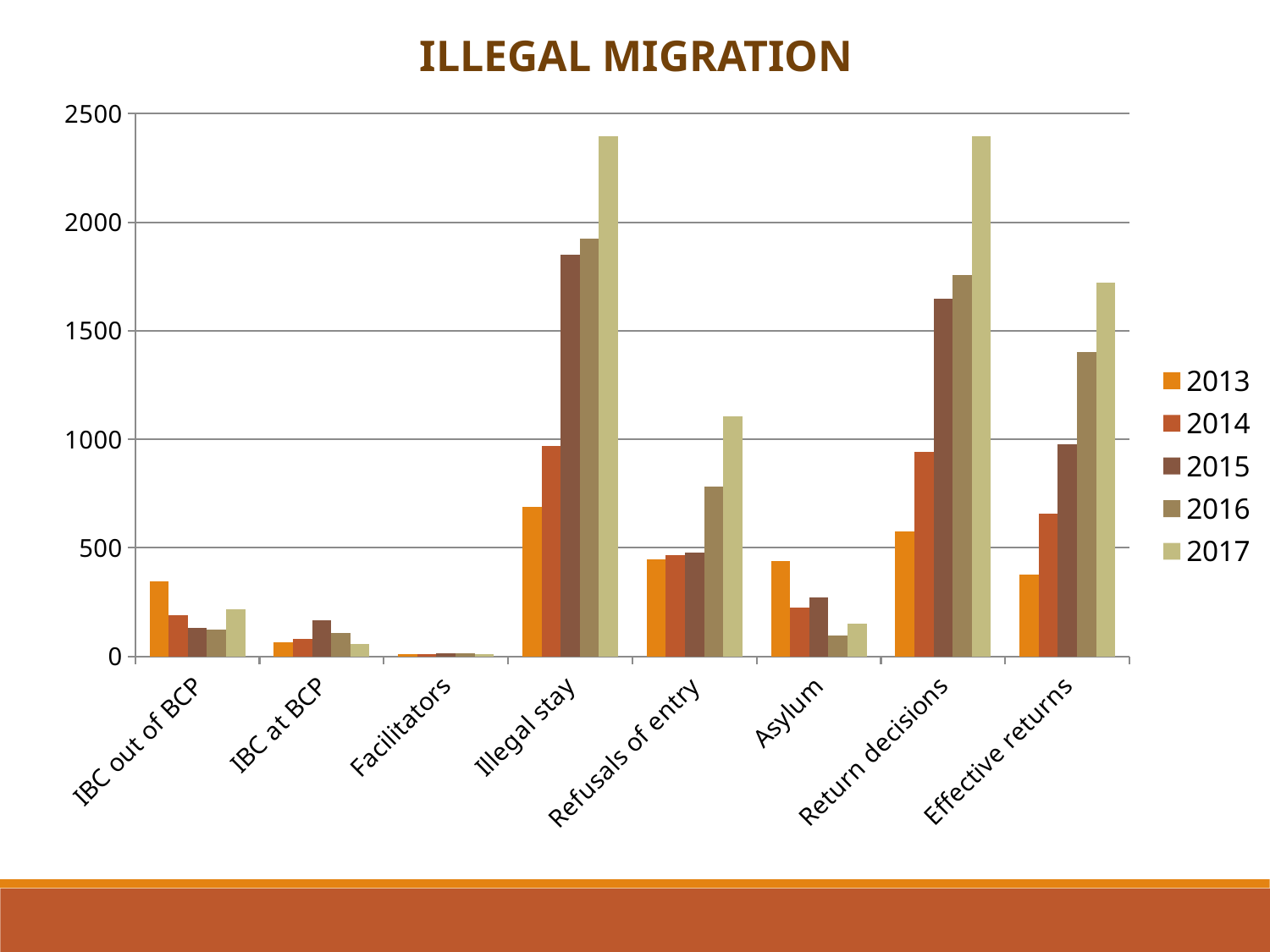
Is the 2017 value for Illegal stay greater or less than 2000? greater Is the 2014 value for Return decisions greater or less than 500? greater How many series does the legend list? 5 Is the 2016 value for Effective returns greater or less than 1500? less How many categories are shown along the x axis? 8 Do the values for Effective returns rise or fall from 2013 to 2017? rise Which category has the highest 2013 value? Illegal stay What kind of chart is shown on the slide? bar chart Which category has the lowest values across all years? Facilitators Which is larger, the 2015 value for Illegal stay or the 2015 value for Return decisions? Illegal stay What is the title of the chart? ILLEGAL MIGRATION